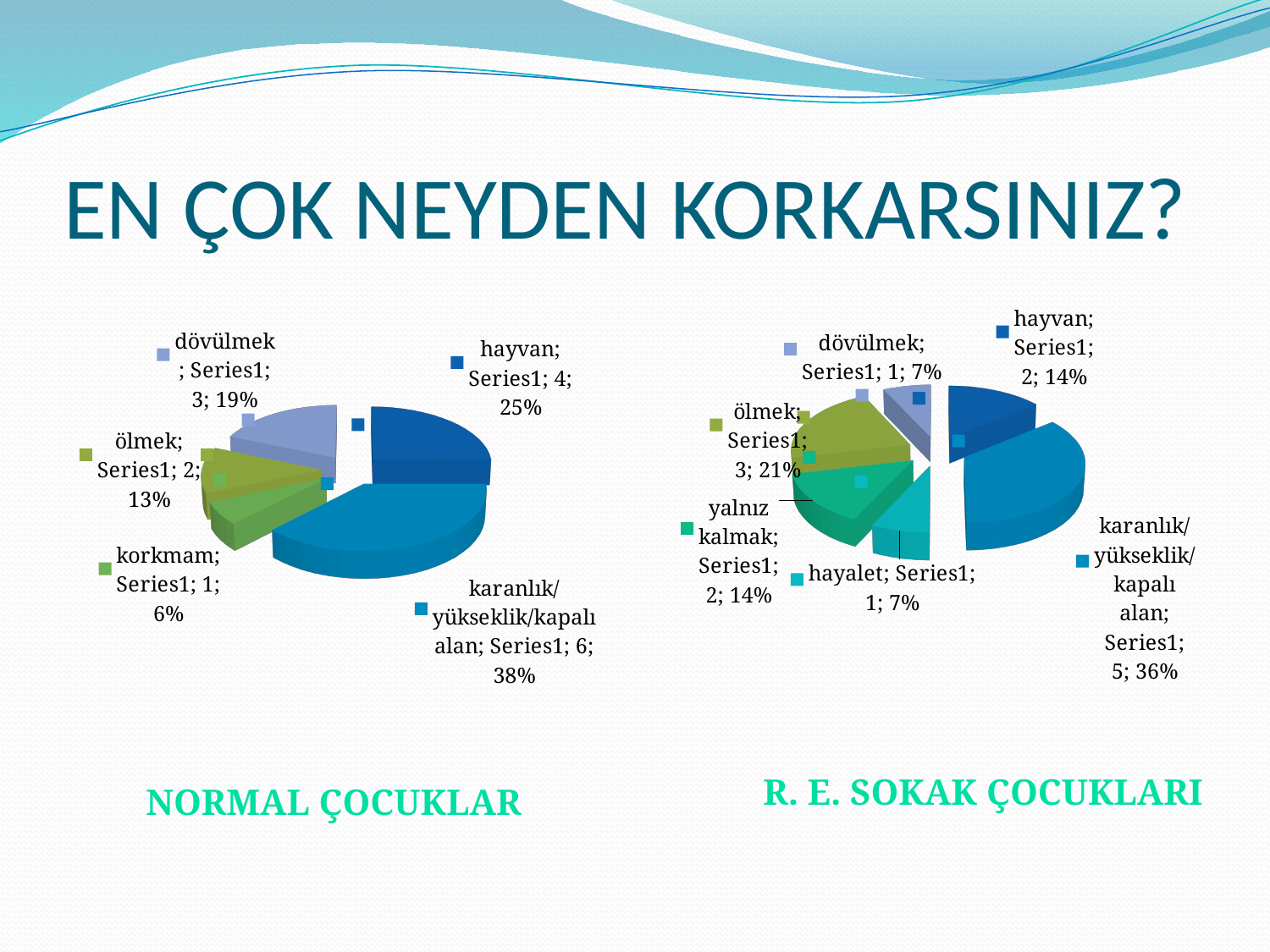
What kind of chart is the NORMAL ÇOCUKLAR chart on the left? pie chart In the NORMAL ÇOCUKLAR chart, which category has the smallest slice? korkmam In the R. E. SOKAK ÇOCUKLARI chart, what share of the pie does yalnız kalmak have? 14% In the NORMAL ÇOCUKLAR chart, how many slices does the pie have? 5 What is the title of the slide above the two charts? EN ÇOK NEYDEN KORKARSINIZ? In the R. E. SOKAK ÇOCUKLARI chart, which is larger, the value for hayvan or the value for hayalet? hayvan In the R. E. SOKAK ÇOCUKLARI chart, which category has the largest slice? karanlık/yükseklik/kapalı alan In the R. E. SOKAK ÇOCUKLARI chart, what is the value for ölmek? 3 In the NORMAL ÇOCUKLAR chart, what is the value for hayvan? 4 In the NORMAL ÇOCUKLAR chart, what share of the pie does karanlık/yükseklik/kapalı alan have? 38% In the R. E. SOKAK ÇOCUKLARI chart, how many slices does the pie have? 6 In the NORMAL ÇOCUKLAR chart, what is the difference between the values for dövülmek and ölmek? 1